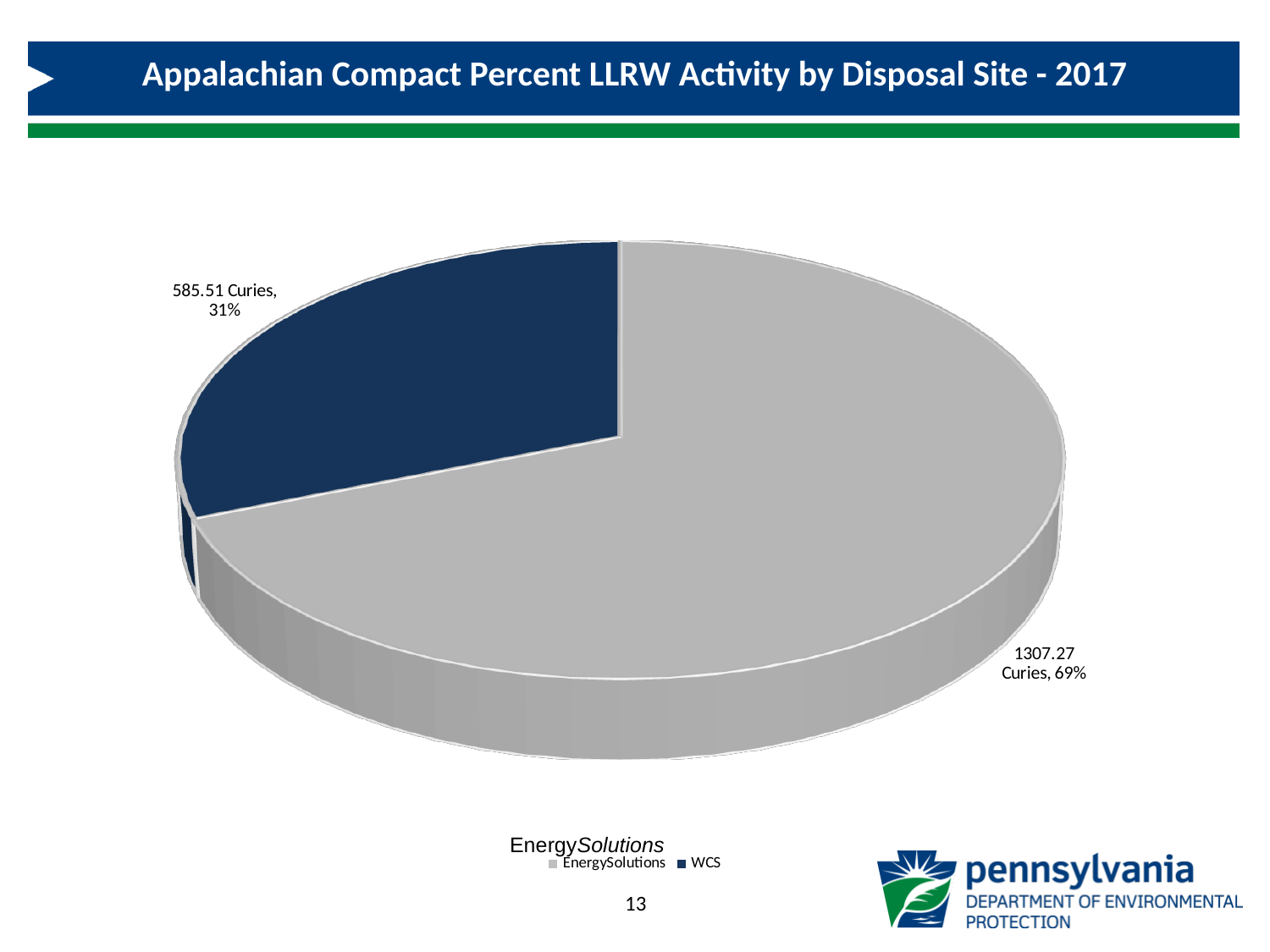
Which is larger, the value for EnergySolutions or the value for WCS? EnergySolutions How many curies are shown for EnergySolutions? 1307.27 Curies How many curies are shown for WCS? 585.51 Curies What share of the pie does WCS account for? 31% What kind of chart is shown on the slide? pie chart Which disposal site has the smallest slice of the pie? WCS What is the title of the chart? Appalachian Compact Percent LLRW Activity by Disposal Site - 2017 How many slices does the pie chart have? 2 How many entries does the legend list? 2 What is the difference in curies between EnergySolutions and WCS? 721.76 Curies Which disposal site has the largest slice of the pie? EnergySolutions What share of the pie does EnergySolutions account for? 69%